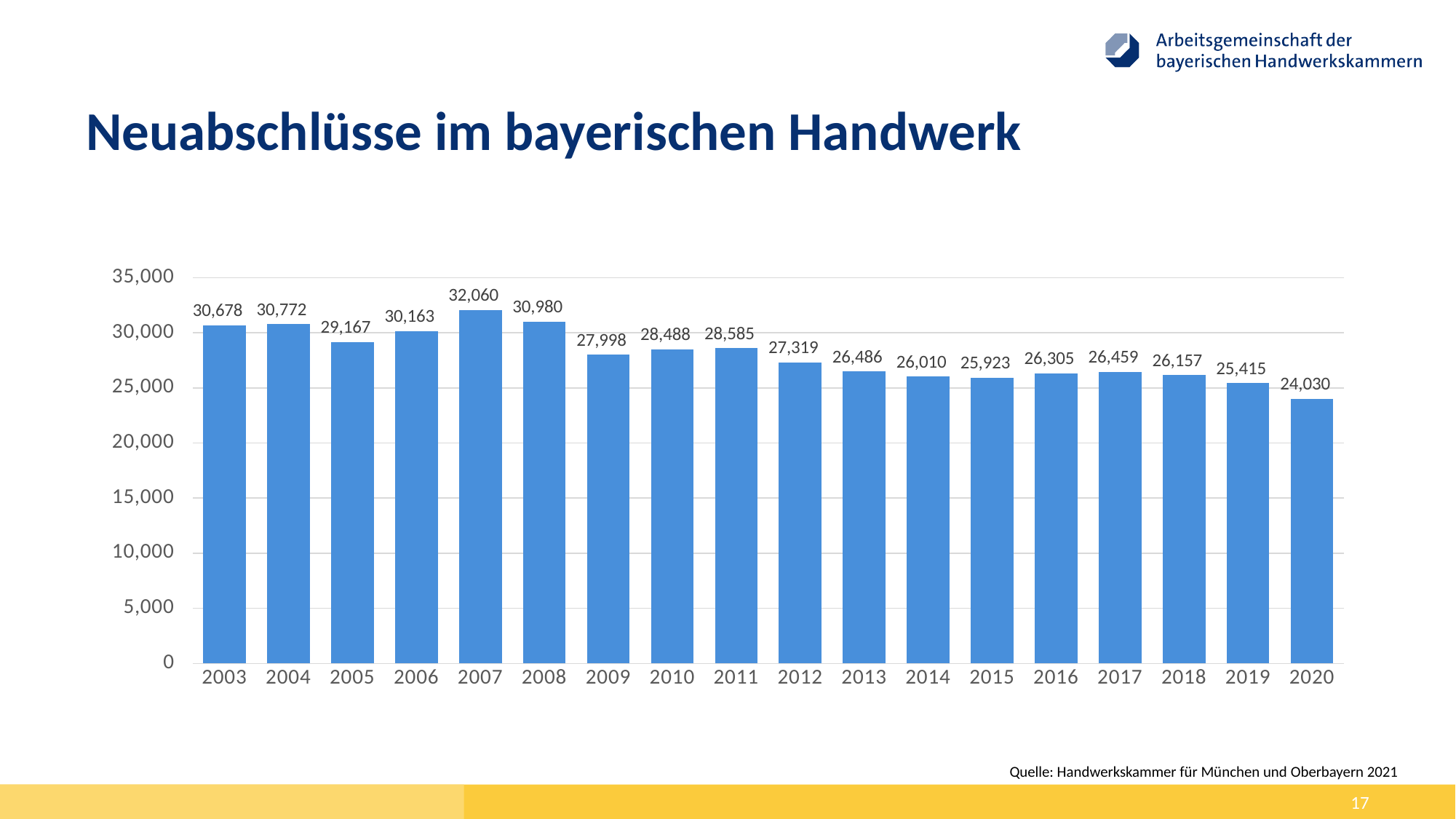
What kind of chart is shown on the slide? bar chart Which is larger, the value for 2010 or the value for 2011? 2011 What is the title of the chart on the slide? Neuabschlüsse im bayerischen Handwerk Is the value for 2005 greater or less than 30,000? less What is the difference between the values for 2019 and 2020? 1,385 What is the value for 2007? 32,060 Which year has the lowest value? 2020 How many years are shown on the x axis? 18 What is the difference between the values for 2007 and 2020? 8,030 What is the value for 2020? 24,030 Which year has the highest value? 2007 What is the value for 2012? 27,319